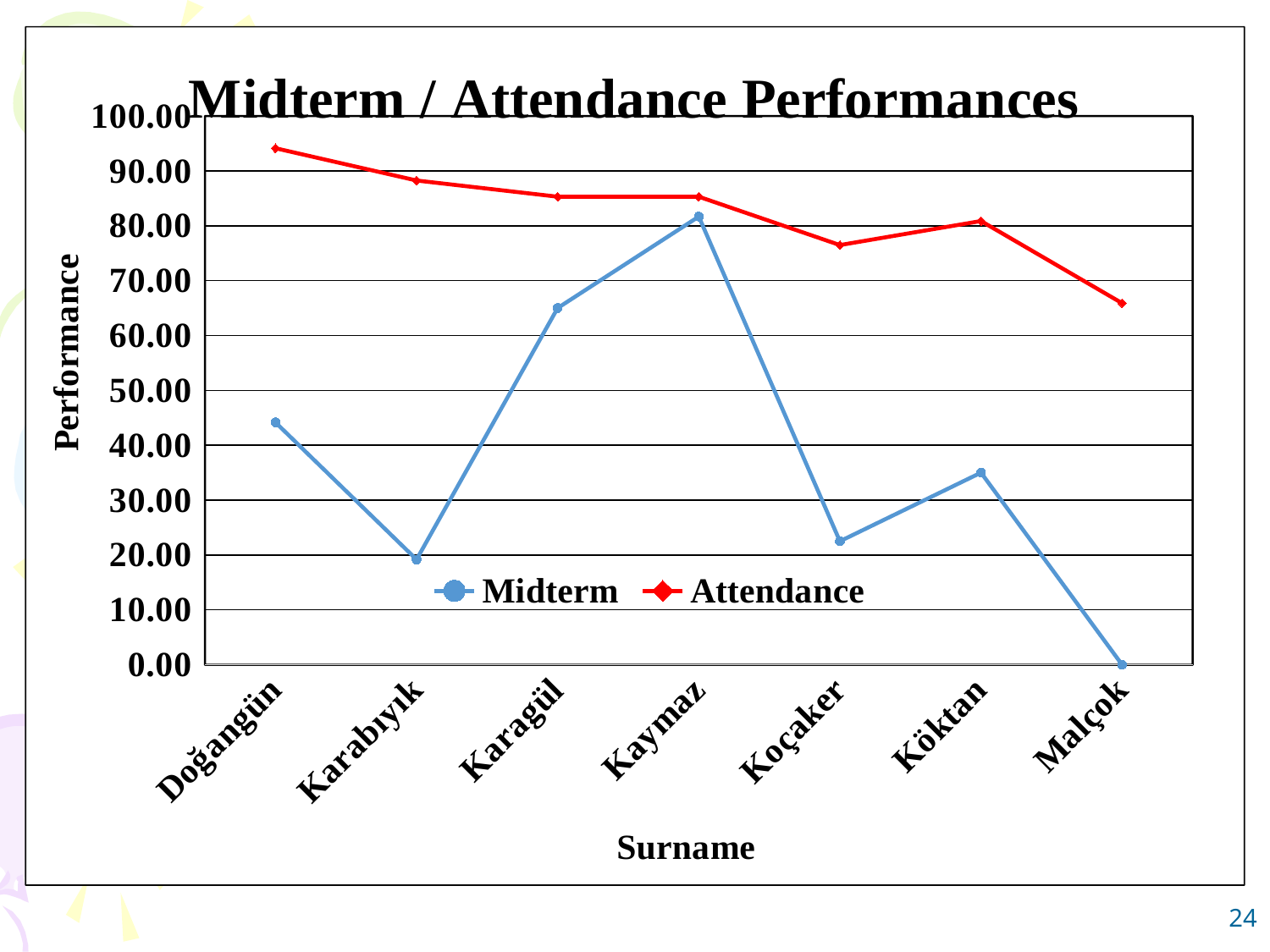
Which surname has the lowest Attendance value? Malçok Which surname has the highest Attendance value? Doğangün Which surname has the lowest Midterm value? Malçok How many surnames are plotted along the x axis? 7 Is the Attendance value for Koçaker greater or less than 80.00? less Is the Midterm value for Doğangün greater or less than 40.00? greater Which is larger, the Midterm value for Karagül or the Midterm value for Köktan? Karagül How many series does the legend list? 2 Does the Attendance line generally rise or fall from Doğangün to Malçok? fall Which surname has the highest Midterm value? Kaymaz What is the label of the x axis? Surname What kind of chart is shown on the slide? line chart